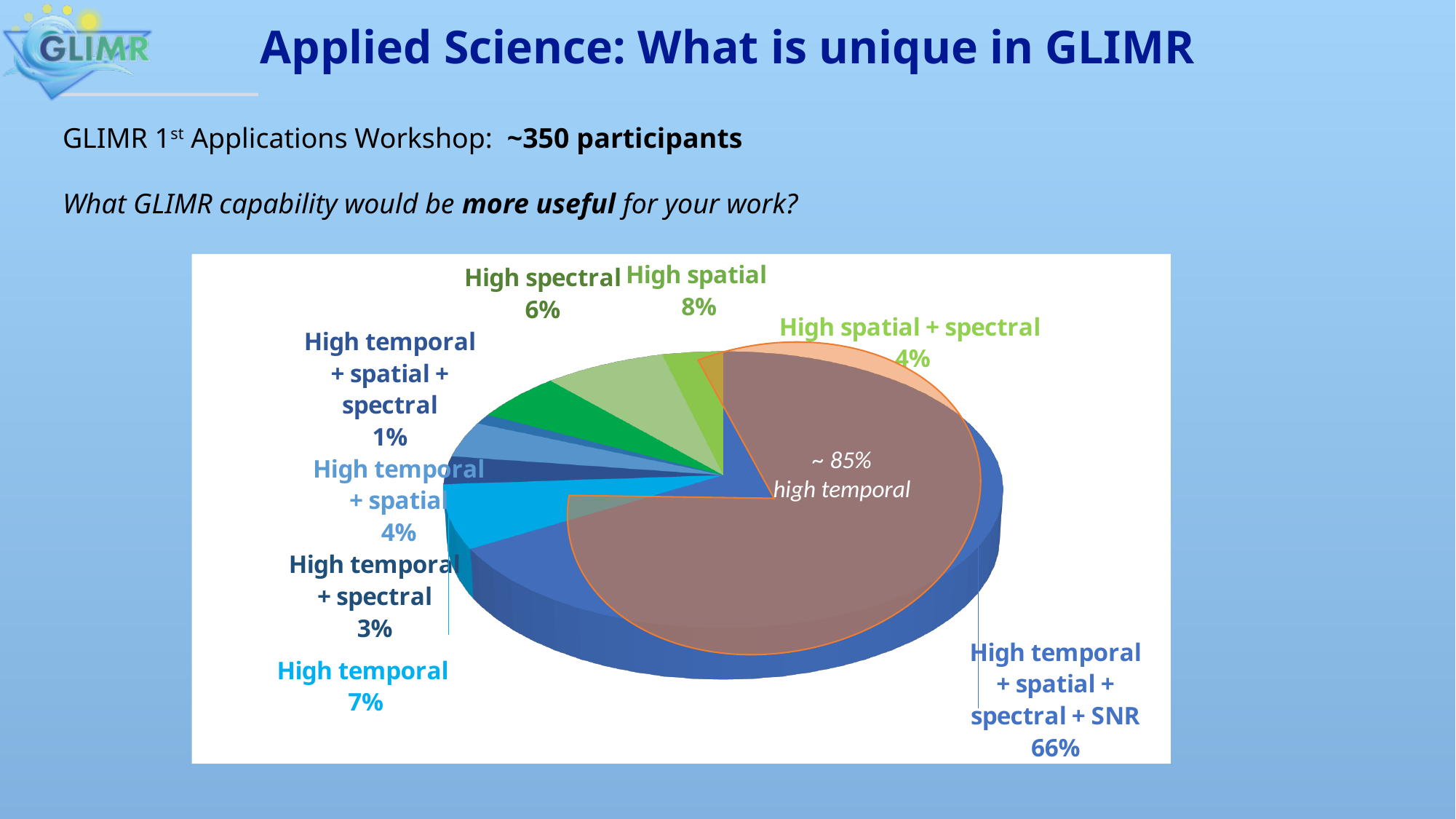
Which category has the largest slice of the pie? High temporal + spatial + spectral + SNR What kind of chart is shown on the slide? pie chart What is the difference between the values for 'High spatial' and 'High spectral'? 2% How many slices does the pie chart have? 8 What is the value for 'High spectral'? 6% What share of the pie does 'High temporal + spatial + spectral + SNR' have? 66% What is the value for 'High spatial'? 8% What is the value for 'High temporal'? 7% Which category has the smallest slice of the pie? High temporal + spatial + spectral What percentage is annotated inside the pie as 'high temporal'? ~ 85% What is the value for 'High temporal + spectral'? 3% Which is larger, the value for 'High temporal' or the value for 'High temporal + spatial'? High temporal